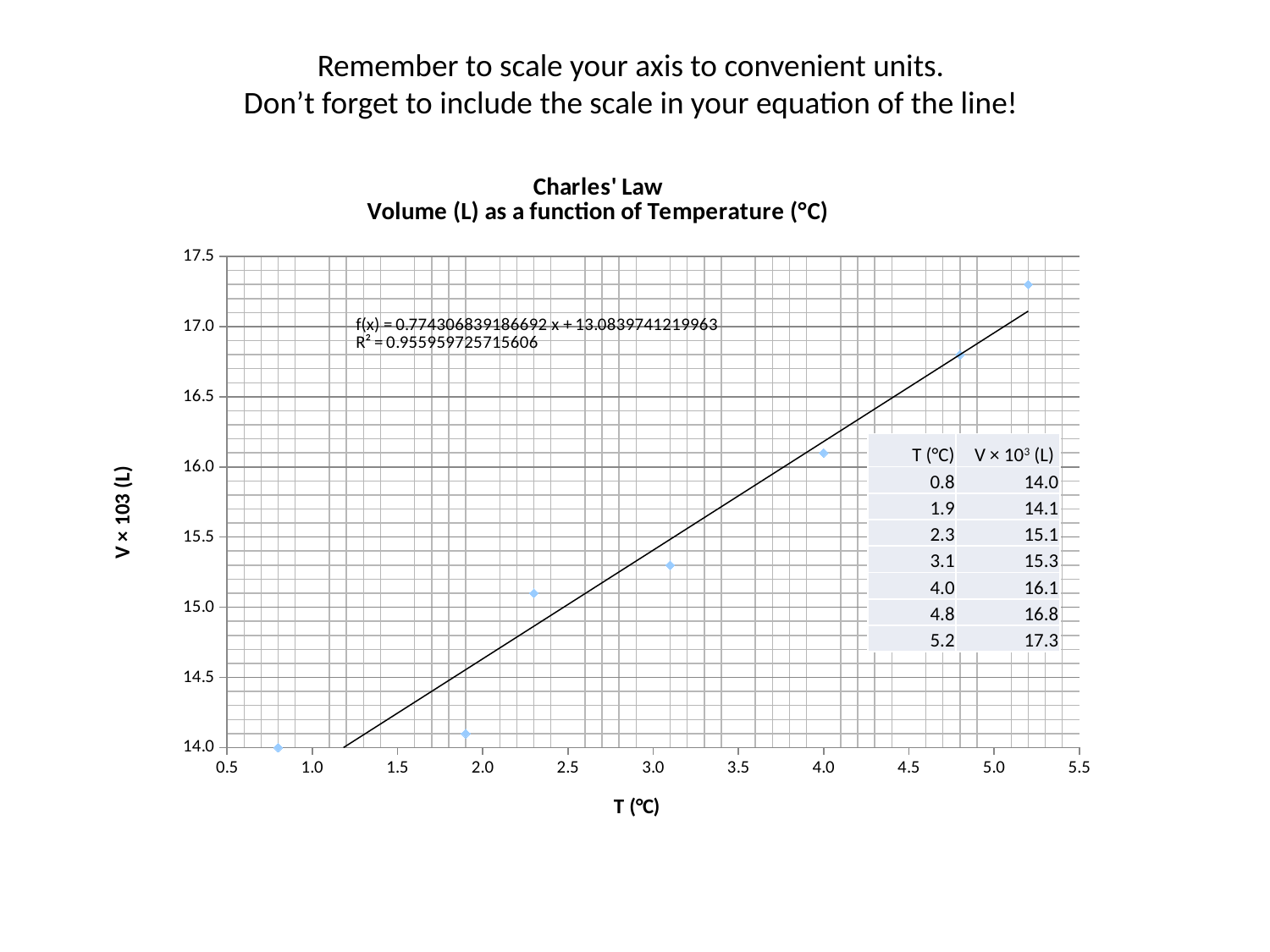
Do the plotted values rise or fall as temperature increases along the x axis? rise At which temperature is the plotted volume highest? 5.2 How many data points are plotted on the chart? 7 What is the difference between the highest and lowest plotted V × 10³ (L) values? 3.3 What is the value of V × 10³ (L) at T = 4.0 °C? 16.1 Which temperature has the larger volume value, 1.9 °C or 2.3 °C? 2.3 What is the title of the chart? Charles' Law Volume (L) as a function of Temperature (°C) What is the lowest plotted value of V × 10³ (L)? 14.0 Is the value for T = 3.1 °C greater or less than 15.0? greater What is the R² value shown on the chart? 0.955959725715606 What is the value of V × 10³ (L) at T = 0.8 °C? 14.0 What kind of chart is shown on the slide? scatter chart